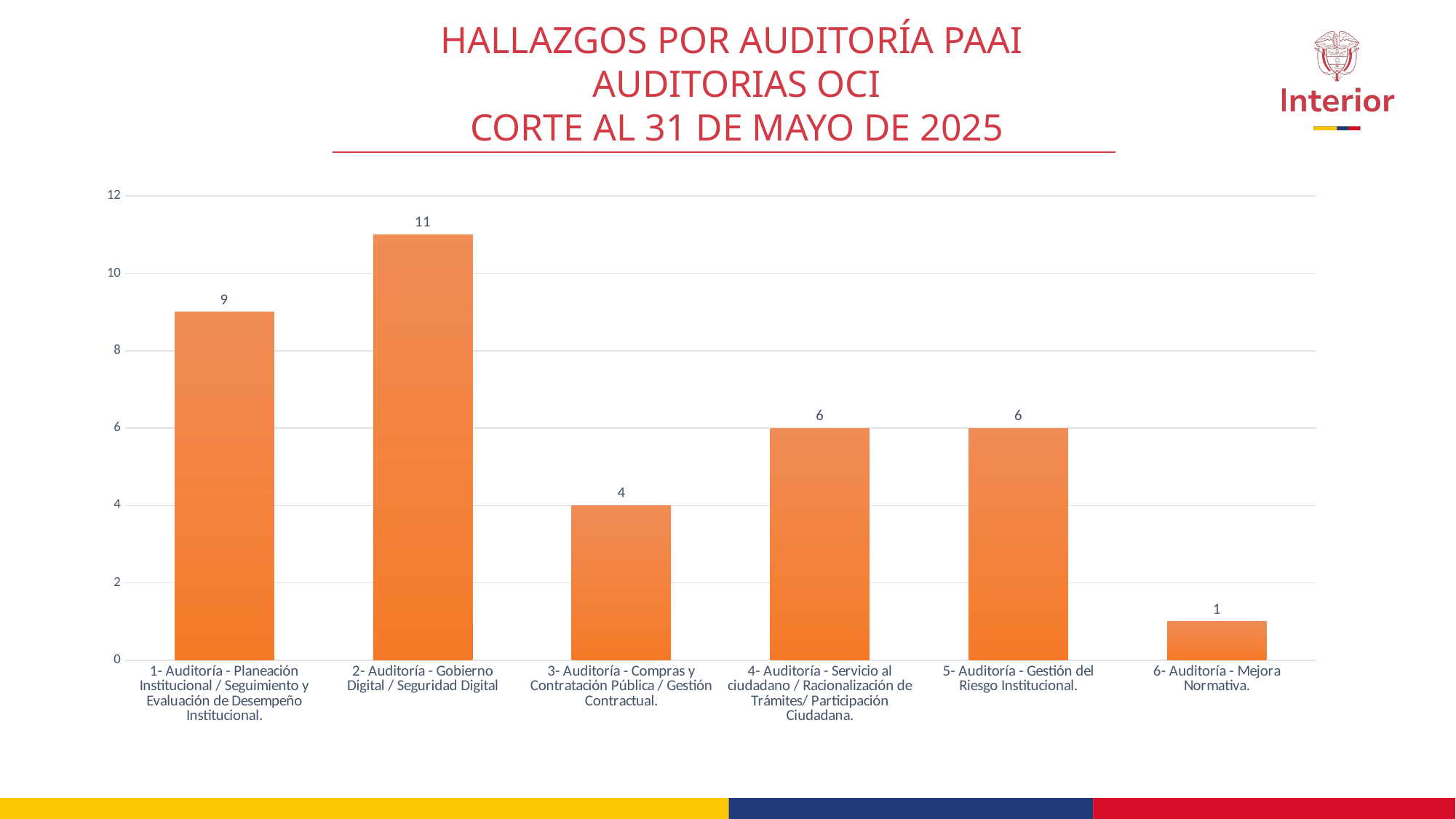
Is the value for '1- Auditoría - Planeación Institucional' greater or less than 8? greater Which audit has the highest number of hallazgos? 2- Auditoría - Gobierno Digital / Seguridad Digital What kind of chart is shown on the slide? Bar chart How many audit categories are plotted on the chart? 6 What is the difference between the values for audit 2 (Gobierno Digital / Seguridad Digital) and audit 1 (Planeación Institucional)? 2 Which audit has the lowest number of hallazgos? 6- Auditoría - Mejora Normativa. Which has more hallazgos: '1- Auditoría - Planeación Institucional' or '4- Auditoría - Servicio al ciudadano'? 1- Auditoría - Planeación Institucional What is the value for '6- Auditoría - Mejora Normativa.'? 1 What is the cut-off date stated in the chart title? 31 de mayo de 2025 What is the value for '3- Auditoría - Compras y Contratación Pública / Gestión Contractual.'? 4 How many hallazgos are shown for '2- Auditoría - Gobierno Digital / Seguridad Digital'? 11 What is the total of the values for audits 4 and 5 (Servicio al ciudadano and Gestión del Riesgo Institucional)? 12